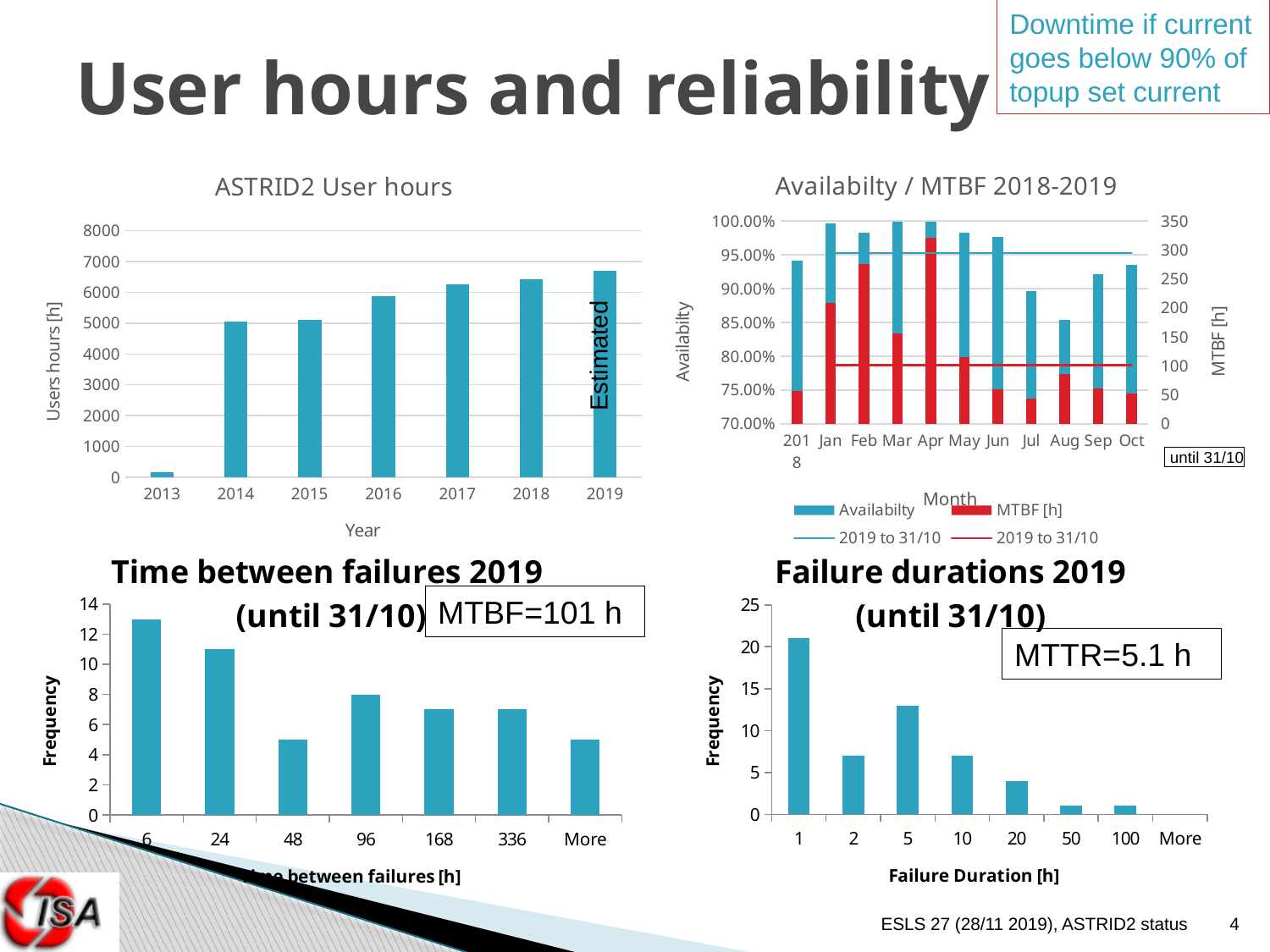
What MTTR value is shown in the text box on the 'Failure durations 2019 (until 31/10)' chart? MTTR=5.1 h In the 'ASTRID2 User hours' chart, which year has the highest user hours? 2019 In the 'Time between failures 2019 (until 31/10)' chart, which bin has the highest frequency? 6 How many years are shown on the x axis of the 'ASTRID2 User hours' chart? 7 In the 'ASTRID2 User hours' chart, is the value for 2017 greater or less than 6000? greater What type of chart is the 'ASTRID2 User hours' chart? bar chart In the 'Time between failures 2019 (until 31/10)' chart, what is the frequency for the 96 bin? 8 In the 'Failure durations 2019 (until 31/10)' chart, is the frequency for the 1 bin greater or less than 20? greater In the 'Availabilty / MTBF 2018-2019' chart, which month has the highest MTBF? Apr In the 'ASTRID2 User hours' chart, which year has the lowest user hours? 2013 In the 'Availabilty / MTBF 2018-2019' chart, which month has the lowest availability? Aug How many entries does the legend of the 'Availabilty / MTBF 2018-2019' chart list? 4